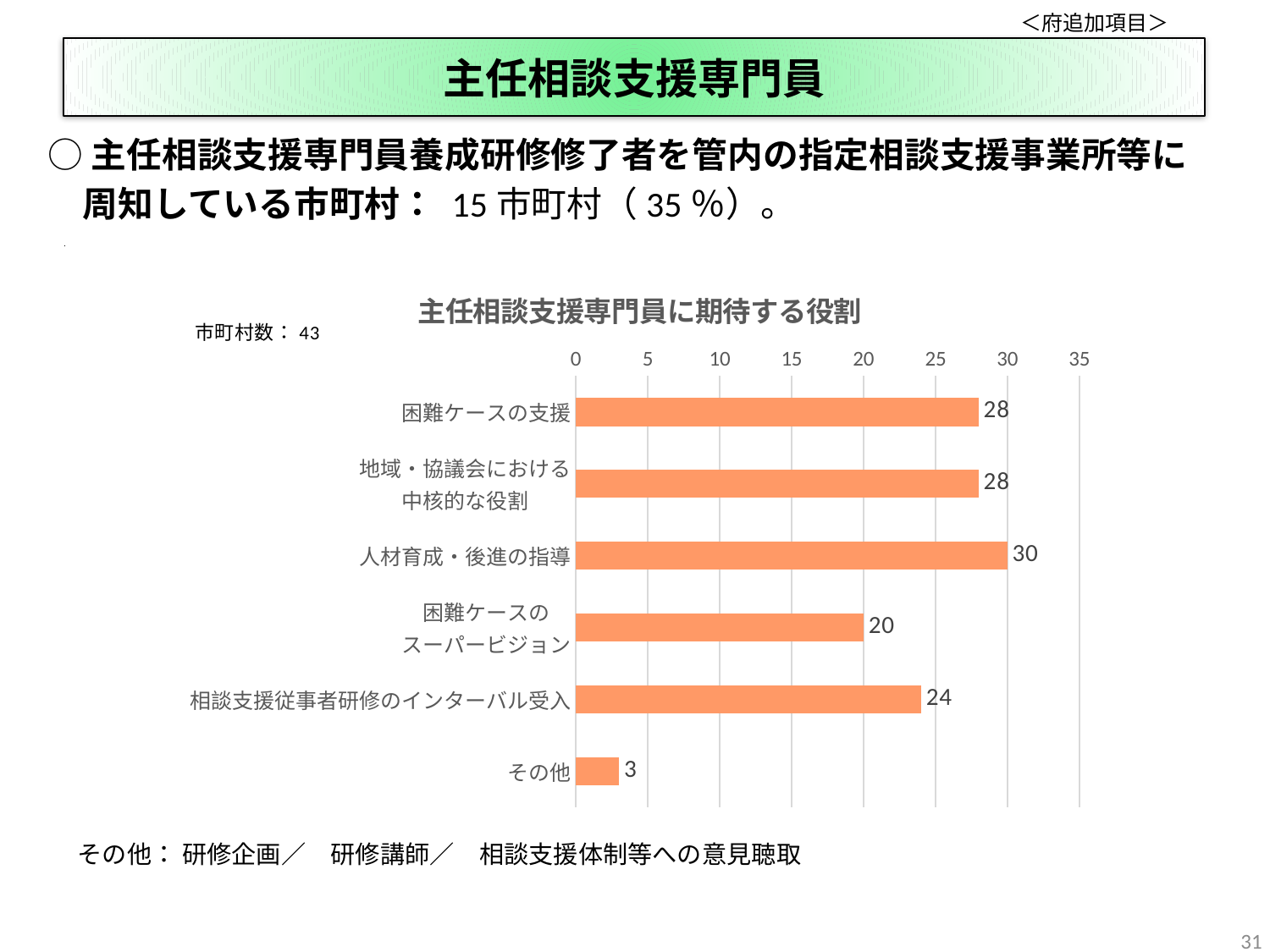
Which category has the lowest value? その他 What is the value for 人材育成・後進の指導? 30 What is the title of the chart? 主任相談支援専門員に期待する役割 Which category has the highest value? 人材育成・後進の指導 What is the value for 相談支援従事者研修のインターバル受入? 24 What is the difference between the values for 人材育成・後進の指導 and 困難ケースのスーパービジョン? 10 What is the value for 困難ケースのスーパービジョン? 20 What kind of chart is shown on the slide? bar chart What is the value for 困難ケースの支援? 28 What is the value for その他? 3 How many categories are shown in the chart? 6 Which is larger, the value for 相談支援従事者研修のインターバル受入 or the value for 困難ケースのスーパービジョン? 相談支援従事者研修のインターバル受入